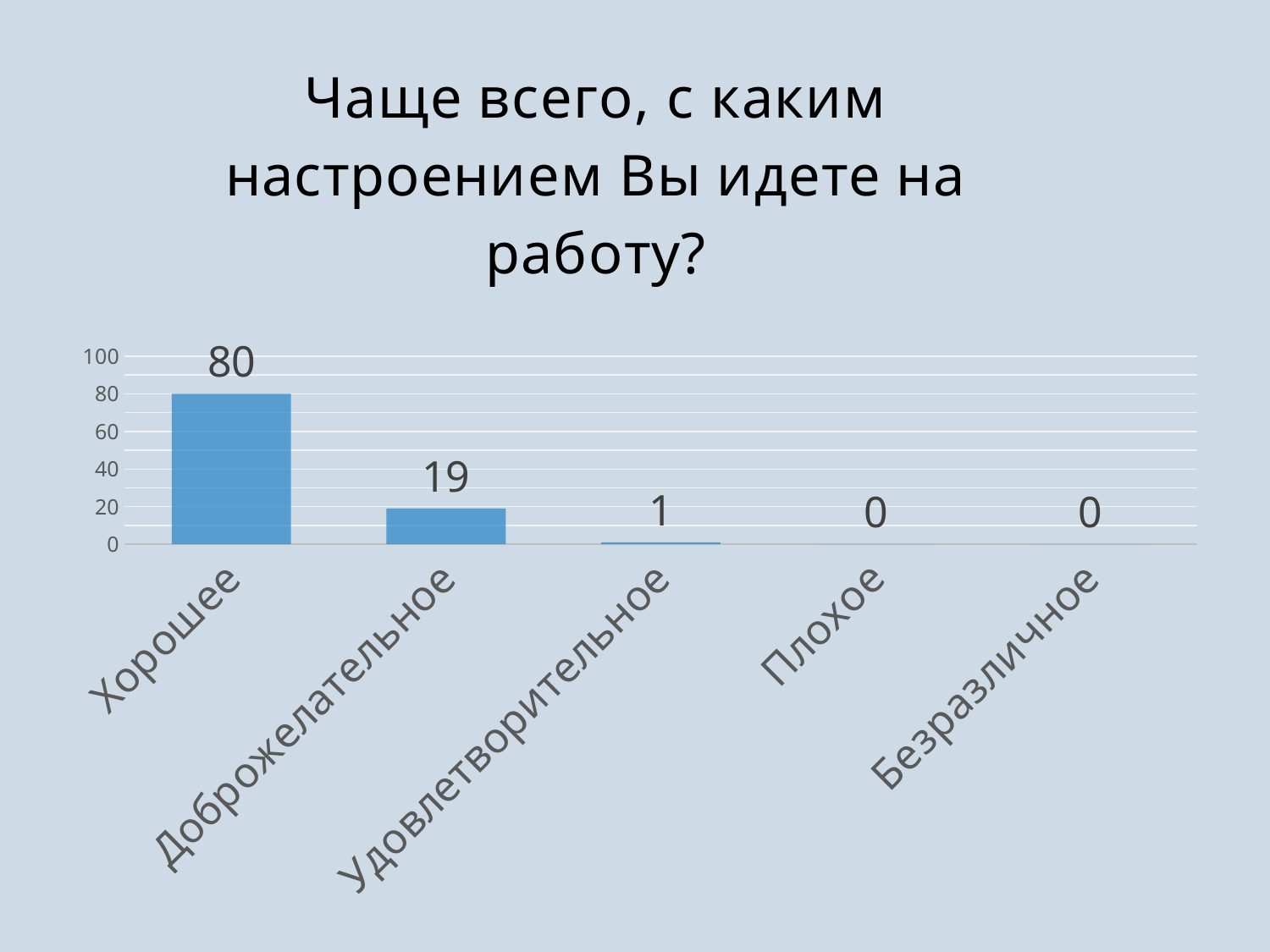
What is the title of the slide? Чаще всего, с каким настроением Вы идете на работу? Which is larger, the value for Доброжелательное or the value for Удовлетворительное? Доброжелательное Which category has the highest value? Хорошее Do the values rise or fall from left to right along the x axis? fall How many categories are shown on the x axis? 5 Is the value for Хорошее greater or less than 60? greater What kind of chart is shown on the slide? bar chart What is the value for Доброжелательное? 19 What is the value for Хорошее? 80 What is the difference between the values for Хорошее and Доброжелательное? 61 What is the value for Удовлетворительное? 1 What is the value for Плохое? 0